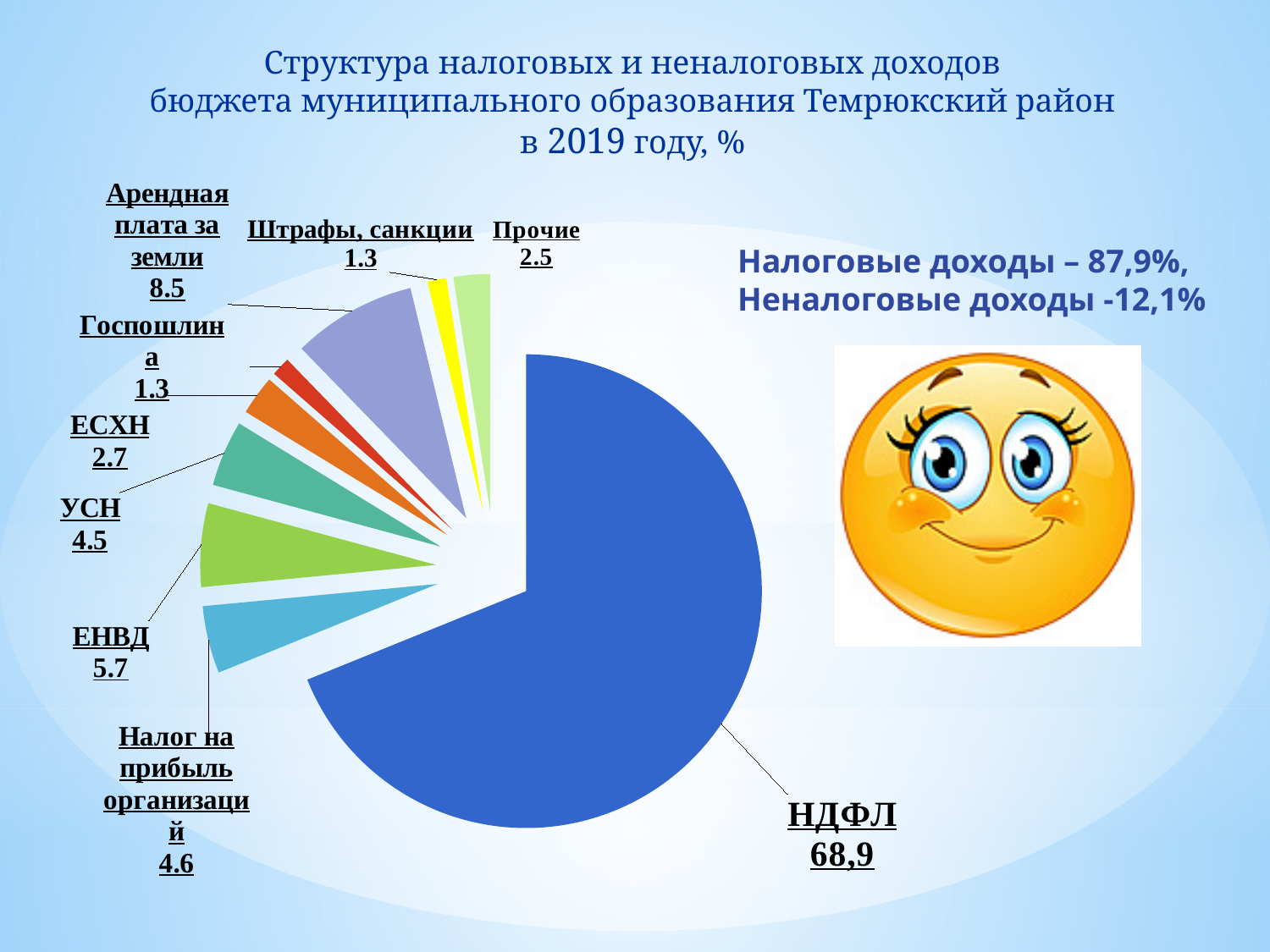
What is the value shown for ЕСХН? 2.7 What is the value shown for НДФЛ? 68,9 What is the value shown for Арендная плата за земли? 8.5 Which category has the largest slice of the pie? НДФЛ What is the difference between the values for Арендная плата за земли and ЕНВД? 2.8 What is the difference between the values for ЕНВД and УСН? 1.2 What is the value shown for ЕНВД? 5.7 Which is larger, ЕНВД or Налог на прибыль организаций? ЕНВД What is the value shown for Прочие? 2.5 How many slices does the pie chart have? 9 According to the text on the slide, what share of revenues is Налоговые доходы? 87,9% What kind of chart is shown on the slide? pie chart